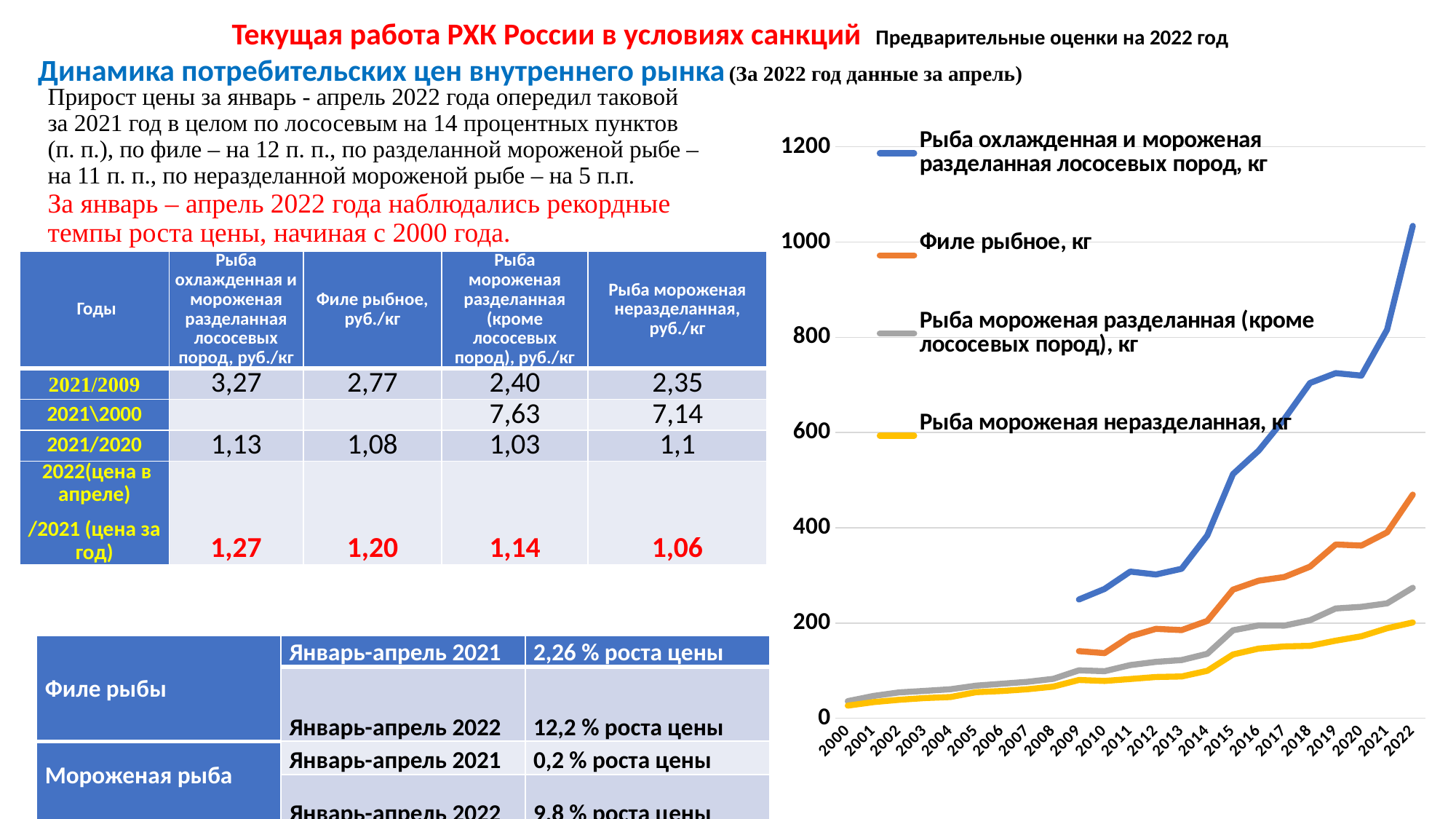
Is the 2022 value for Рыба мороженая неразделанная, кг greater or less than 400? less Which series has the highest value in 2022 on the line chart? Рыба охлажденная и мороженая разделанная лососевых пород, кг In 2022, which is larger: Филе рыбное, кг or Рыба мороженая разделанная (кроме лососевых пород), кг? Филе рыбное, кг What colour is the line for Филе рыбное, кг on the chart? orange Is the 2022 value for Рыба мороженая разделанная (кроме лососевых пород), кг greater or less than 200? greater Which series has the lowest value in 2022 on the line chart? Рыба мороженая неразделанная, кг Does the series Рыба охлажденная и мороженая разделанная лососевых пород, кг rise or fall from 2009 to 2022? rise What kind of chart is shown on the right side of the slide? line chart How many series does the legend of the line chart list? 4 How many years are shown on the x axis of the line chart? 23 Is the 2022 value for Рыба охлажденная и мороженая разделанная лососевых пород, кг greater or less than 800? greater